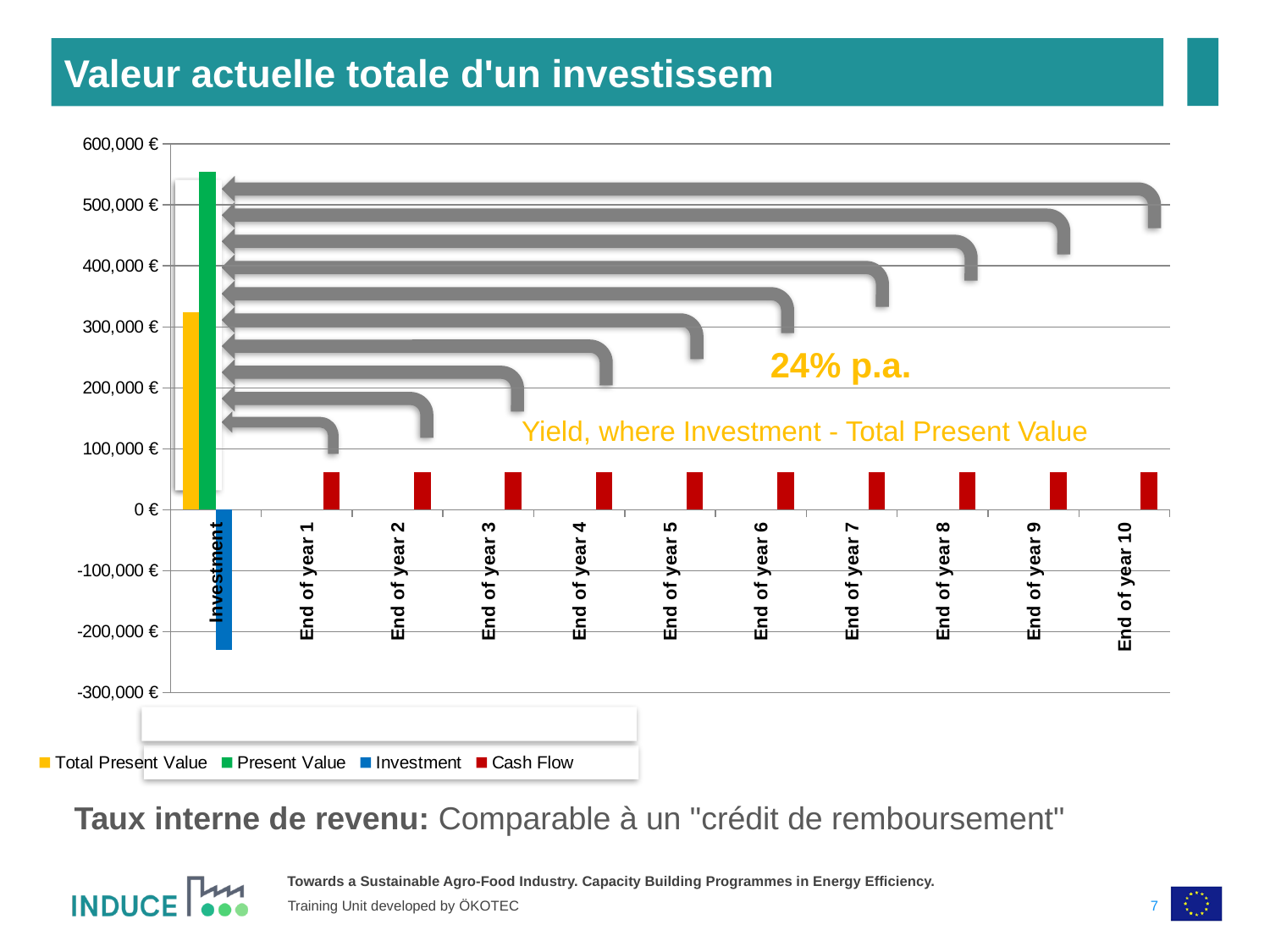
Is the Investment bar (blue) greater or less than -100,000 €? less Which colour represents Cash Flow in the chart legend? red Which is larger, the Present Value bar or the Total Present Value bar? Present Value Is the Total Present Value bar greater or less than 400,000 €? less Is the Cash Flow value for End of year 5 greater or less than 100,000 €? less How many series does the chart legend list? 4 What yield percentage is annotated on the chart? 24% p.a. Do the Cash Flow bars rise, fall or stay the same from End of year 1 to End of year 10? stay the same How many categories are shown on the x axis of the chart? 11 What kind of chart is shown on the slide? bar chart Which series has the tallest bar in the chart? Present Value